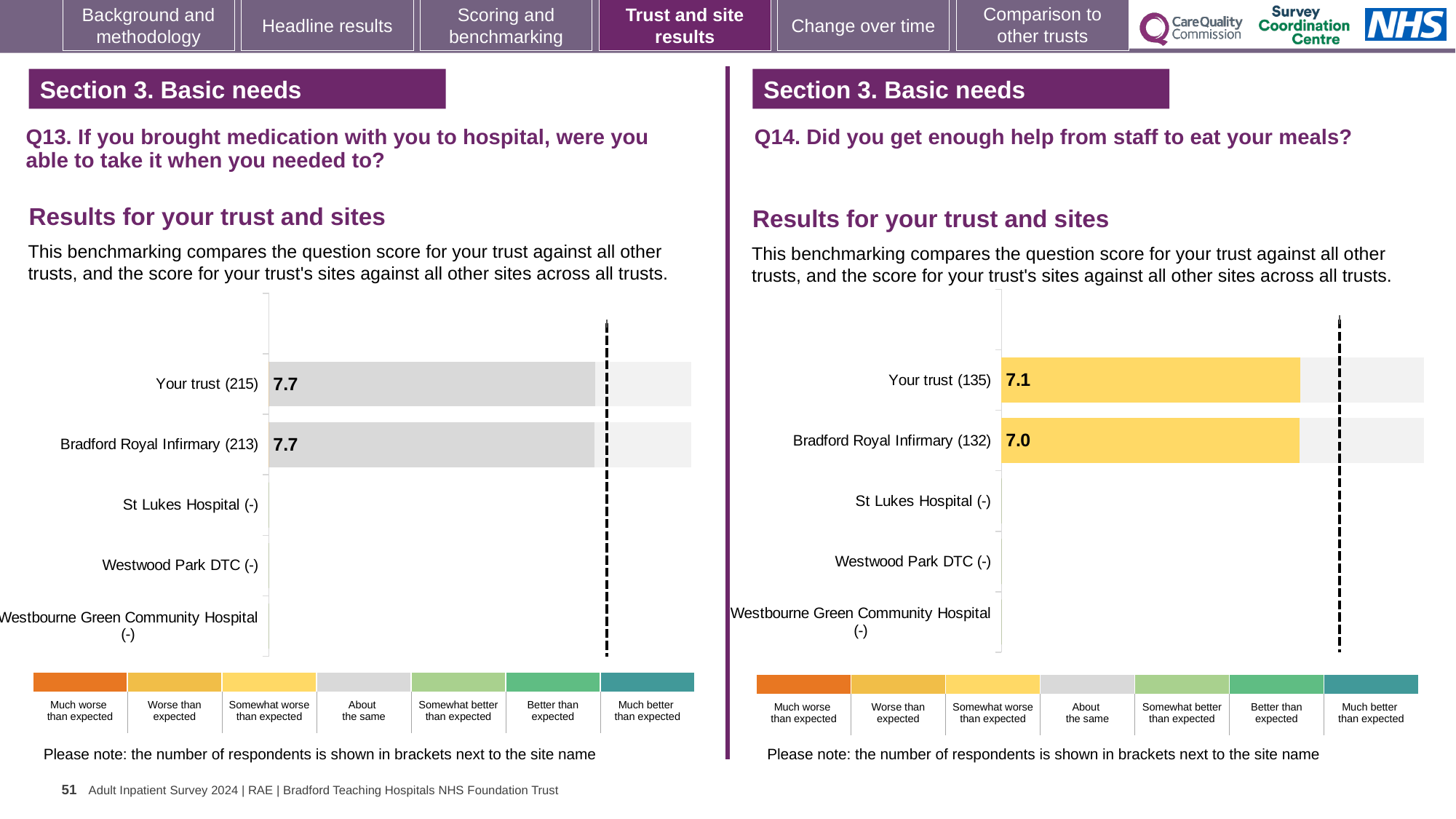
In the Q13 chart on the left, how many rows have a plotted bar with a value? 2 In the Q14 chart on the right, which benchmark category does the yellow bar colour correspond to according to the legend? Somewhat worse than expected In the Q13 chart on the left, which benchmark category does the grey bar colour correspond to according to the legend? About the same In the Q13 chart on the left, what is the score for Bradford Royal Infirmary? 7.7 How many categories (rows) are listed on the y axis of the Q13 chart on the left? 5 In the Q13 chart on the left, how many respondents are shown in brackets for Your trust? 215 In the Q14 chart on the right, what is the difference between the score for Your trust and the score for Bradford Royal Infirmary? 0.1 In the Q14 chart on the right, how many respondents are shown in brackets for Bradford Royal Infirmary? 132 In the Q14 chart on the right, what is the score for Your trust? 7.1 What kind of chart is used in the Q14 chart on the right? Bar chart In the Q13 chart on the left, what is the score for Your trust? 7.7 In the Q14 chart on the right, what is the score for Bradford Royal Infirmary? 7.0